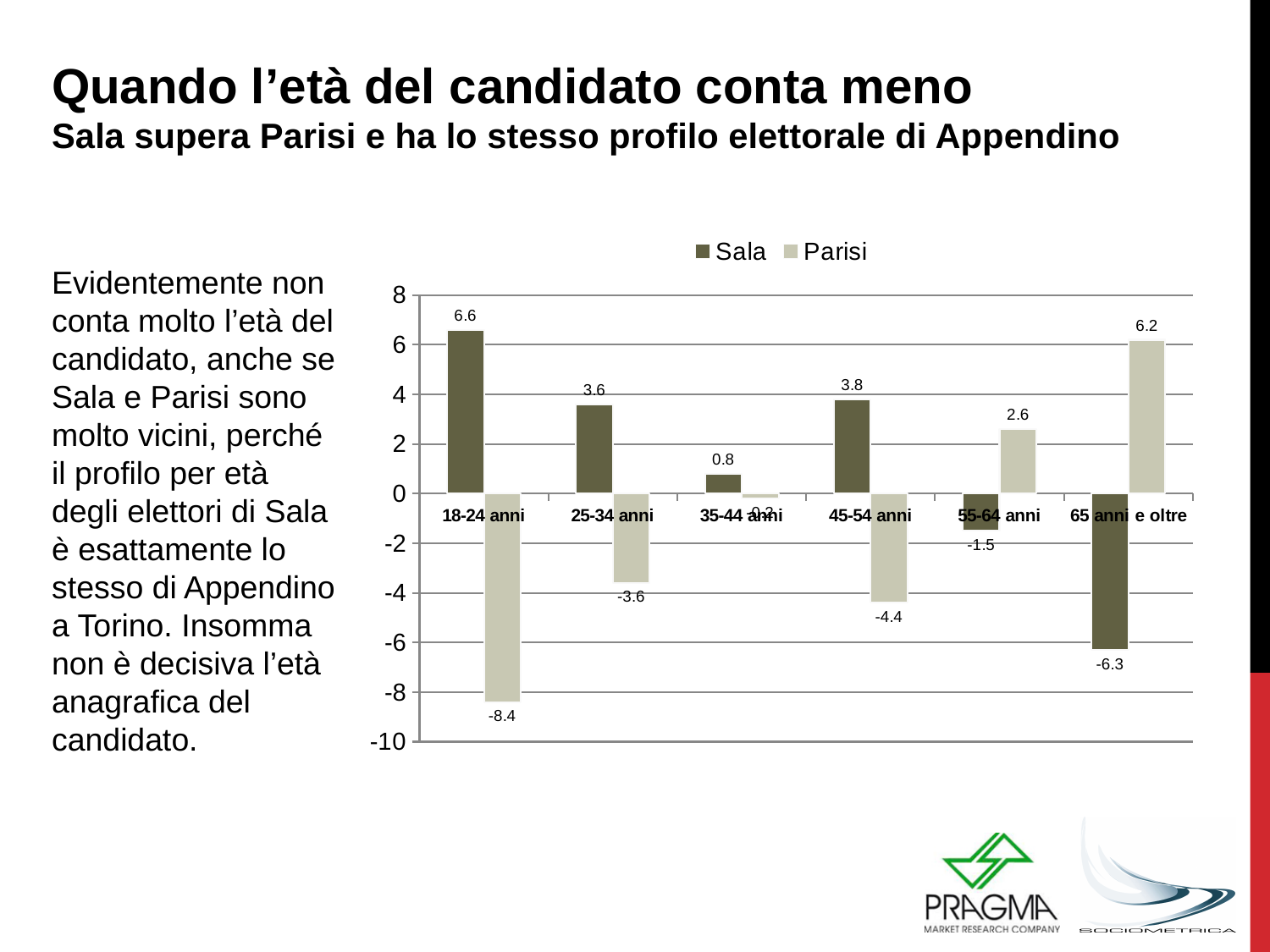
Which is larger in the 25-34 anni category, the value for Sala or the value for Parisi? Sala How many age categories are shown on the x axis? 6 What is the difference between Sala's and Parisi's values in the 45-54 anni category? 8.2 What is the value for Sala in the 18-24 anni category? 6.6 How many series does the legend list? 2 What kind of chart is shown on the slide? bar chart What is the value for Parisi in the 18-24 anni category? -8.4 What is the value for Sala in the 55-64 anni category? -1.5 In which age category does Sala have the highest value? 18-24 anni What is the value for Parisi in the 65 anni e oltre category? 6.2 In which age category does Parisi have the lowest value? 18-24 anni Which series is shown in the dark bars? Sala